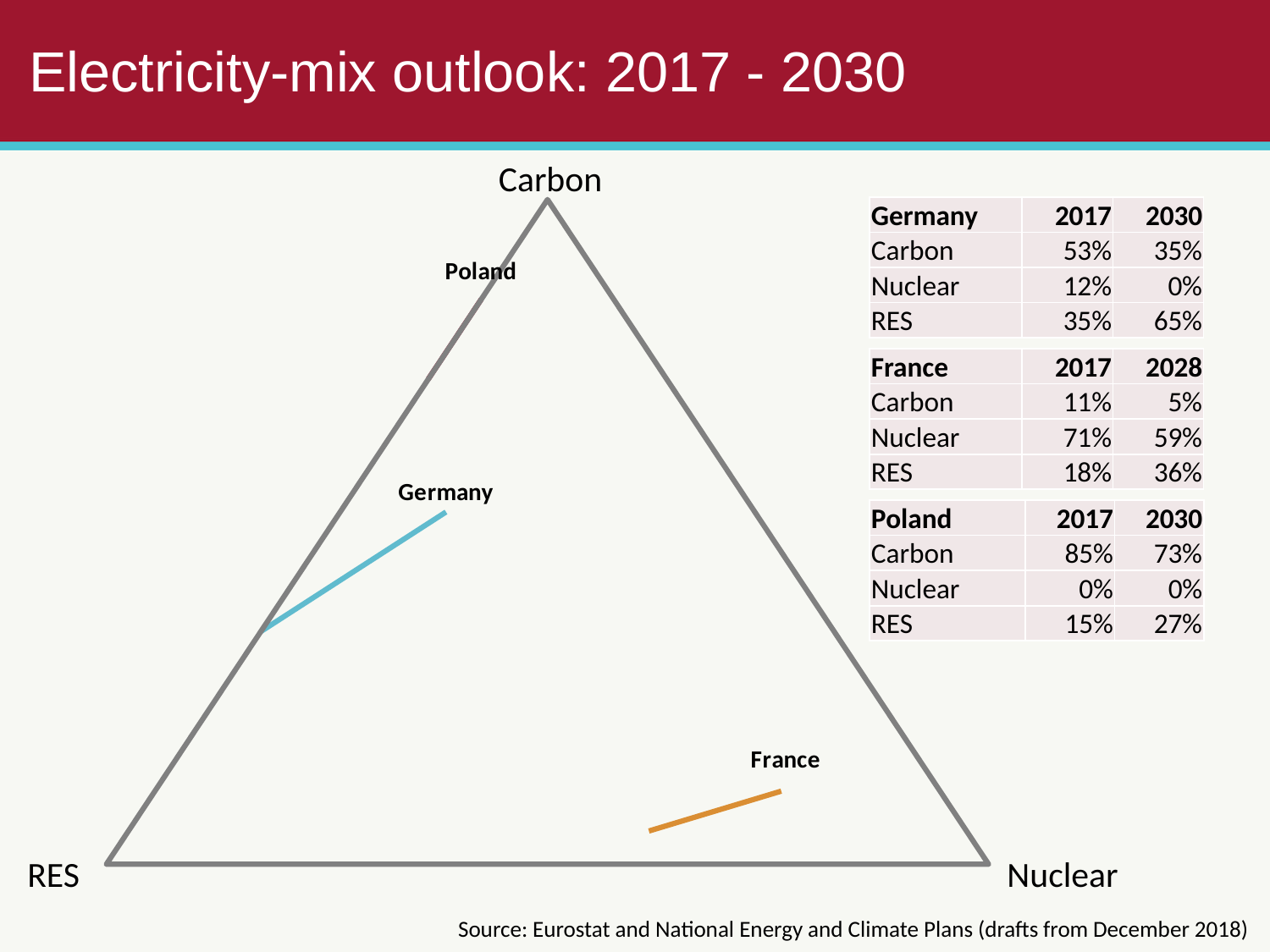
Which country has the highest carbon share in 2017? Poland What kind of chart is shown on the slide? A ternary (triangle) plot By how many percentage points does Poland's carbon share fall from 2017 to 2030? 12 percentage points How many countries are plotted on the triangle chart? 3 What is Poland's carbon share in 2030? 73% What colour is the line plotted for Germany? Blue What are the three corners of the triangle chart labelled? Carbon, RES, Nuclear What is France's nuclear share in 2017? 71% Which has the larger nuclear share in 2017, France or Germany? France What is Germany's RES share in 2030? 65% What is Germany's carbon share in 2017? 53% Does Germany's RES share rise or fall from 2017 to 2030? Rise